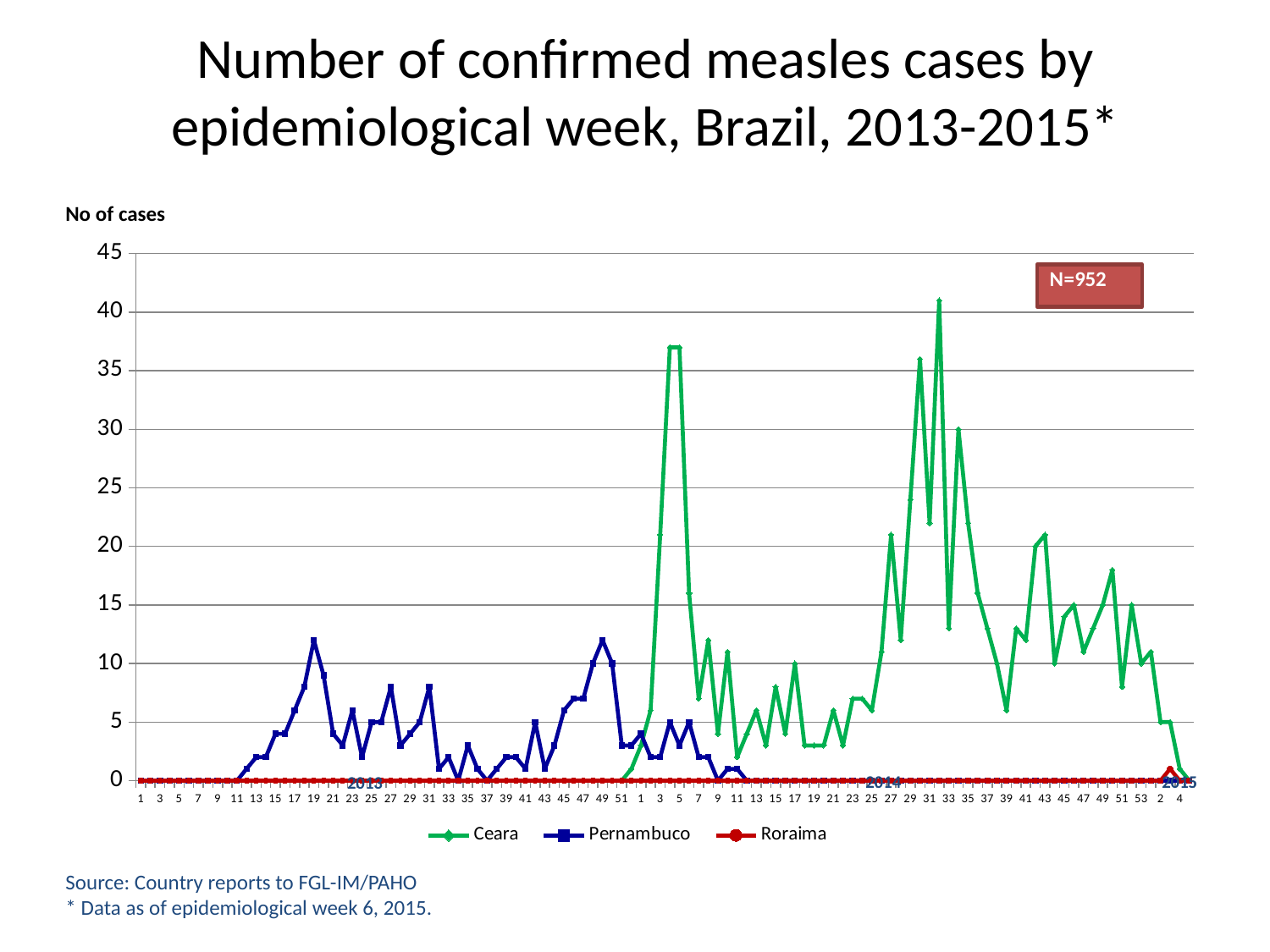
Which series reaches the highest peak on the chart? Ceara Is the highest value reached by Pernambuco greater or less than 15? less Is the highest value reached by Ceara greater or less than 35? greater Do the values for Ceara rise or fall over the final weeks shown in 2015? fall What kind of chart is shown on the slide? line chart Which series shows confirmed cases during the first half of 2013? Pernambuco Which series has the lowest values overall, staying at or near zero for the whole period? Roraima What total N is shown in the box on the chart? N=952 Is the highest value reached by Pernambuco greater or less than 10? greater What is the highest value shown on the y axis? 45 How many series does the legend list? 3 Which series has a higher peak in 2014, Ceara or Pernambuco? Ceara